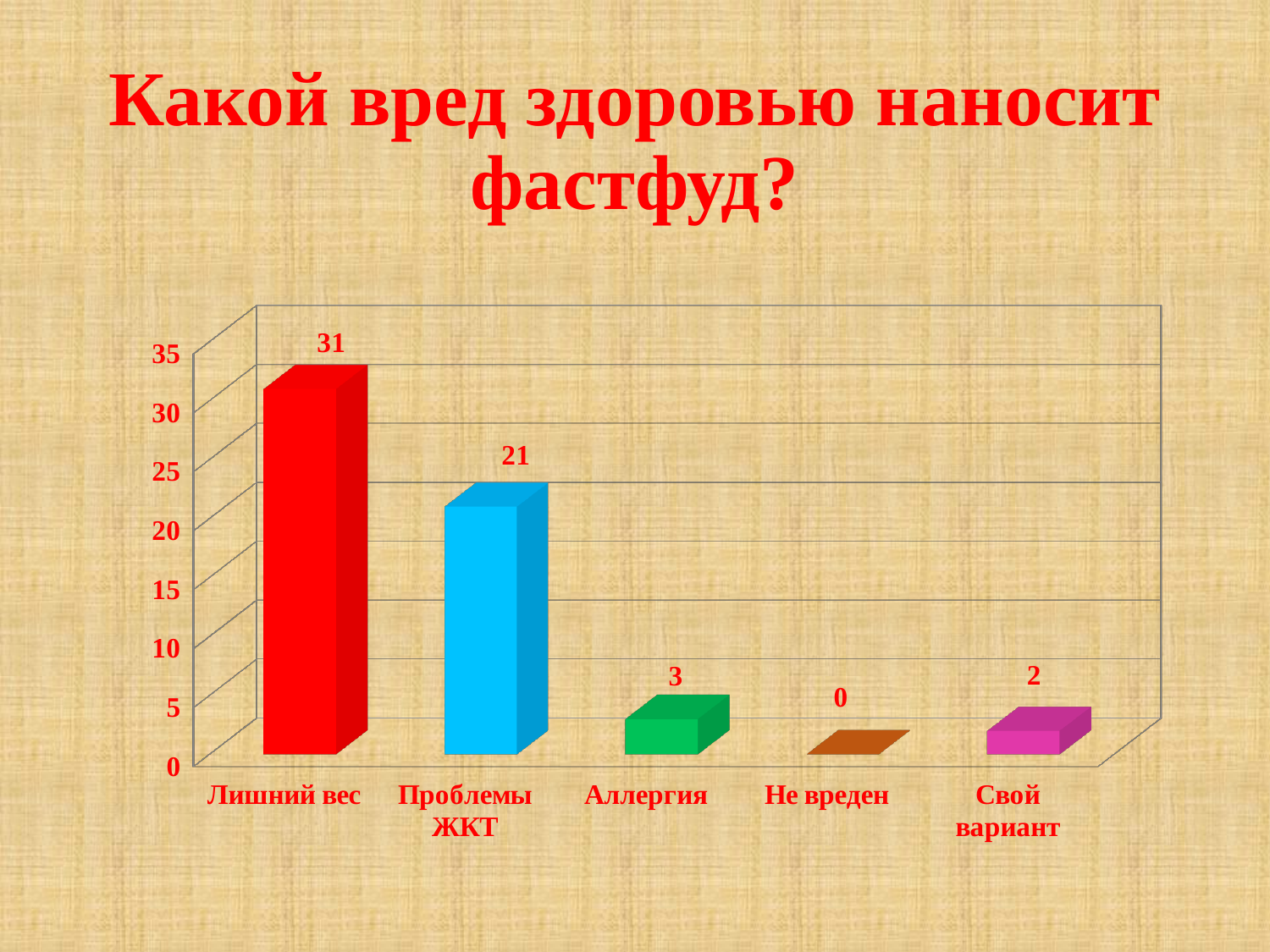
What is the value for Проблемы ЖКТ? 21 What is the difference between the values for Лишний вес and Проблемы ЖКТ? 10 What kind of chart is shown on the slide? bar chart What is the value for Свой вариант? 2 How many categories are shown on the x axis? 5 Which category has the highest value? Лишний вес Is the value for Проблемы ЖКТ greater or less than 25? less What is the value for Лишний вес? 31 Which category has the lowest value? Не вреден Which is larger, the value for Аллергия or the value for Свой вариант? Аллергия What is the value for Не вреден? 0 What is the value for Аллергия? 3